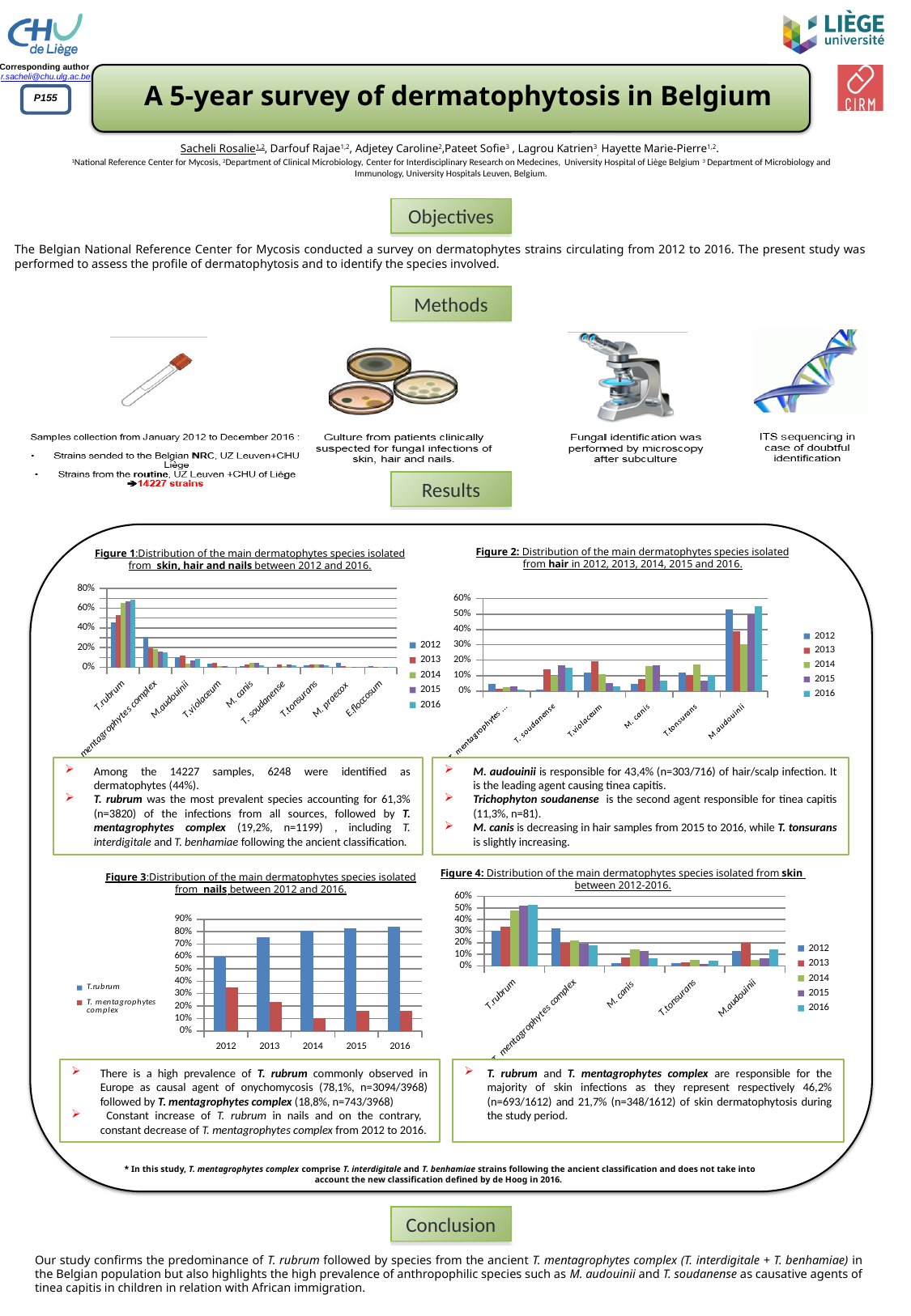
In Figure 2 (hair), how many species categories are shown on the x axis? 6 In Figure 1 (skin, hair and nails), how many species categories are shown on the x axis? 9 In Figure 3 (nails), how many series does the legend list? 2 In Figure 2 (hair), is the value for M.audouinii in 2016 greater or less than 40%? greater In Figure 1 (skin, hair and nails), is the value for T.rubrum in 2012 greater or less than 40%? greater What type of chart is Figure 1 (distribution from skin, hair and nails)? bar chart In Figure 3 (nails), is the value for T. mentagrophytes complex in 2014 greater or less than 20%? less In Figure 1 (skin, hair and nails), which species has the highest values? T.rubrum In Figure 4 (skin), which is larger, the 2012 value for T.rubrum or the 2012 value for M. canis? T.rubrum In Figure 1 (skin, hair and nails), how many series does the legend list? 5 In Figure 3 (nails), does the value for T.rubrum rise or fall from 2012 to 2016? rise In Figure 2 (hair), which species has the highest values? M.audouinii